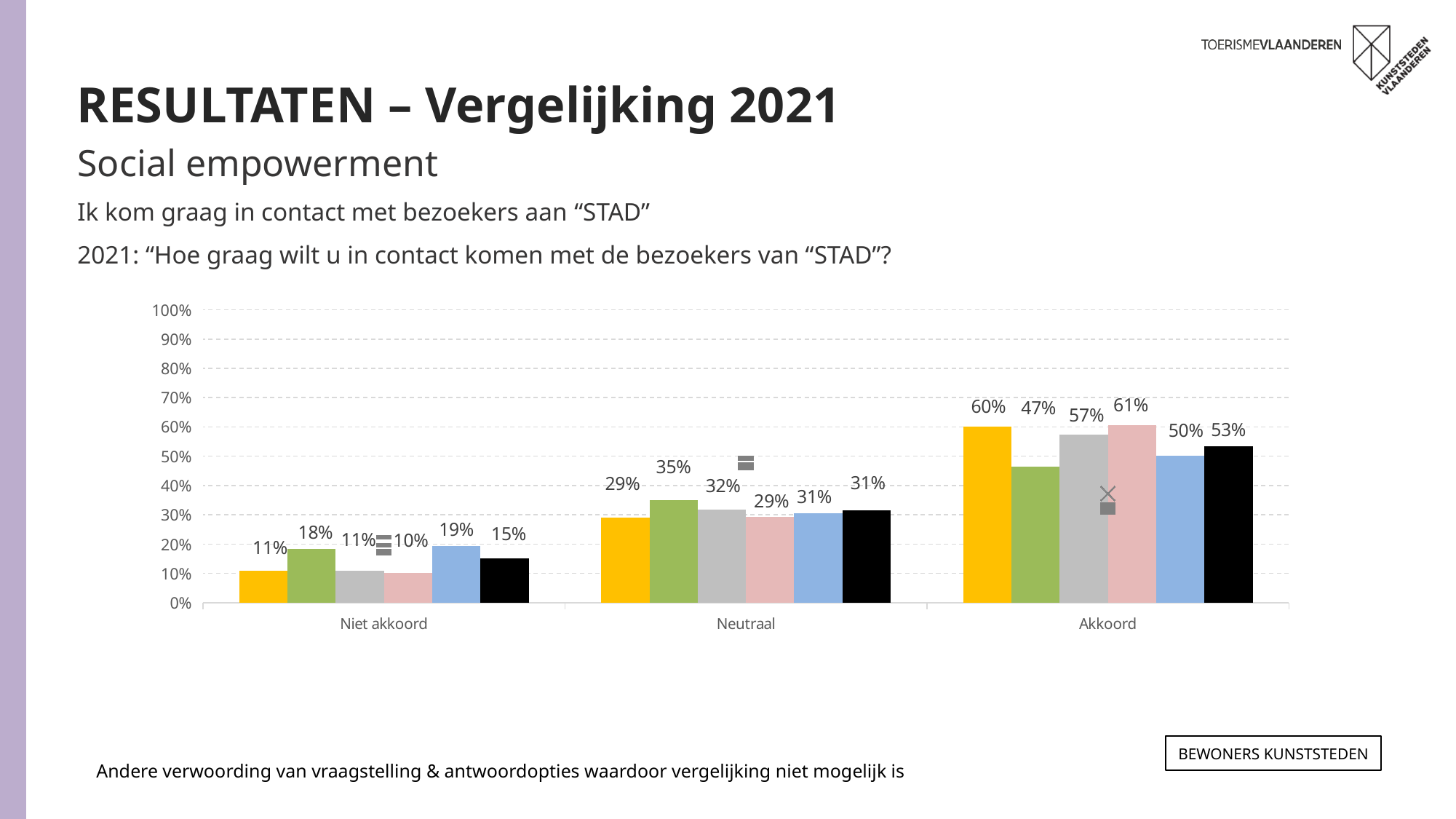
Which bar has the lowest value in the Akkoord category? the green bar (47%) What is the value of the black bar in the Akkoord category? 53% How many categories are shown on the x axis of the chart? 3 What is the value of the pink bar in the Niet akkoord category? 10% What is the value of the green bar in the Neutraal category? 35% What is the value of the yellow bar in the Akkoord category? 60% Which bar has the highest value in the Akkoord category? the pink bar (61%) Which is larger in the Neutraal category: the green bar or the grey bar? the green bar What is the difference between the blue bar and the pink bar in the Niet akkoord category? 9% Is the value of the yellow bar in the Neutraal category greater or less than 40%? less What kind of chart is shown on the slide? bar chart How many bars are plotted in each category of the chart? 6